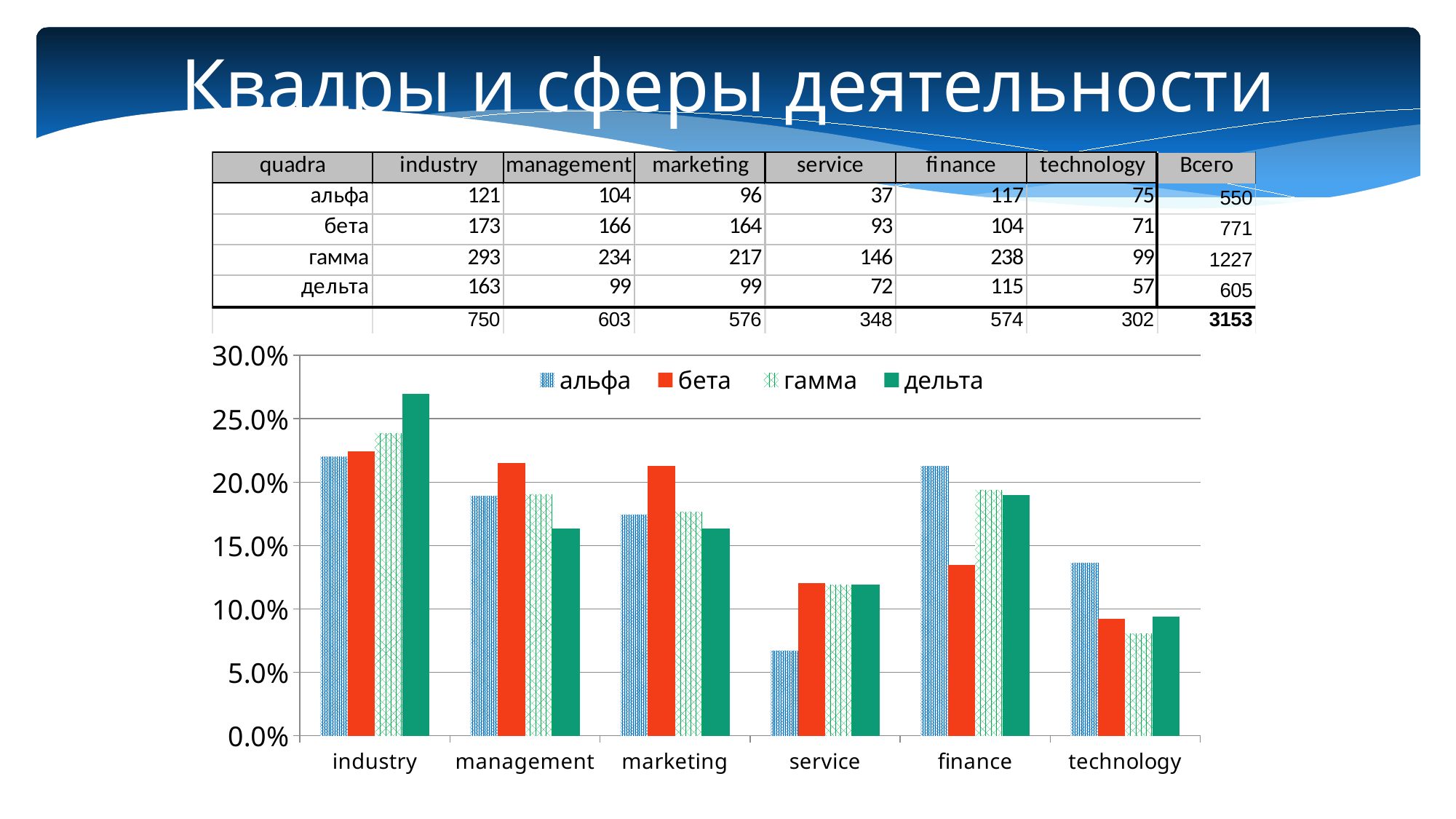
In the finance category, which is larger: the альфа bar or the бета bar? альфа What kind of chart is shown on the slide? bar chart In the marketing category, which series has the highest bar? бета In the technology category, which is larger: the альфа bar or the гамма bar? альфа How many categories are shown along the x axis of the chart? 6 Is the value for бета in management greater or less than 20.0%? greater What are the series names listed in the chart legend? альфа, бета, гамма, дельта In which category is the альфа bar the lowest? service How many series does the chart legend list? 4 In which category is the дельта bar the highest? industry Is the value for альфа in service greater or less than 10.0%? less Is the value for дельта in industry greater or less than 25.0%? greater